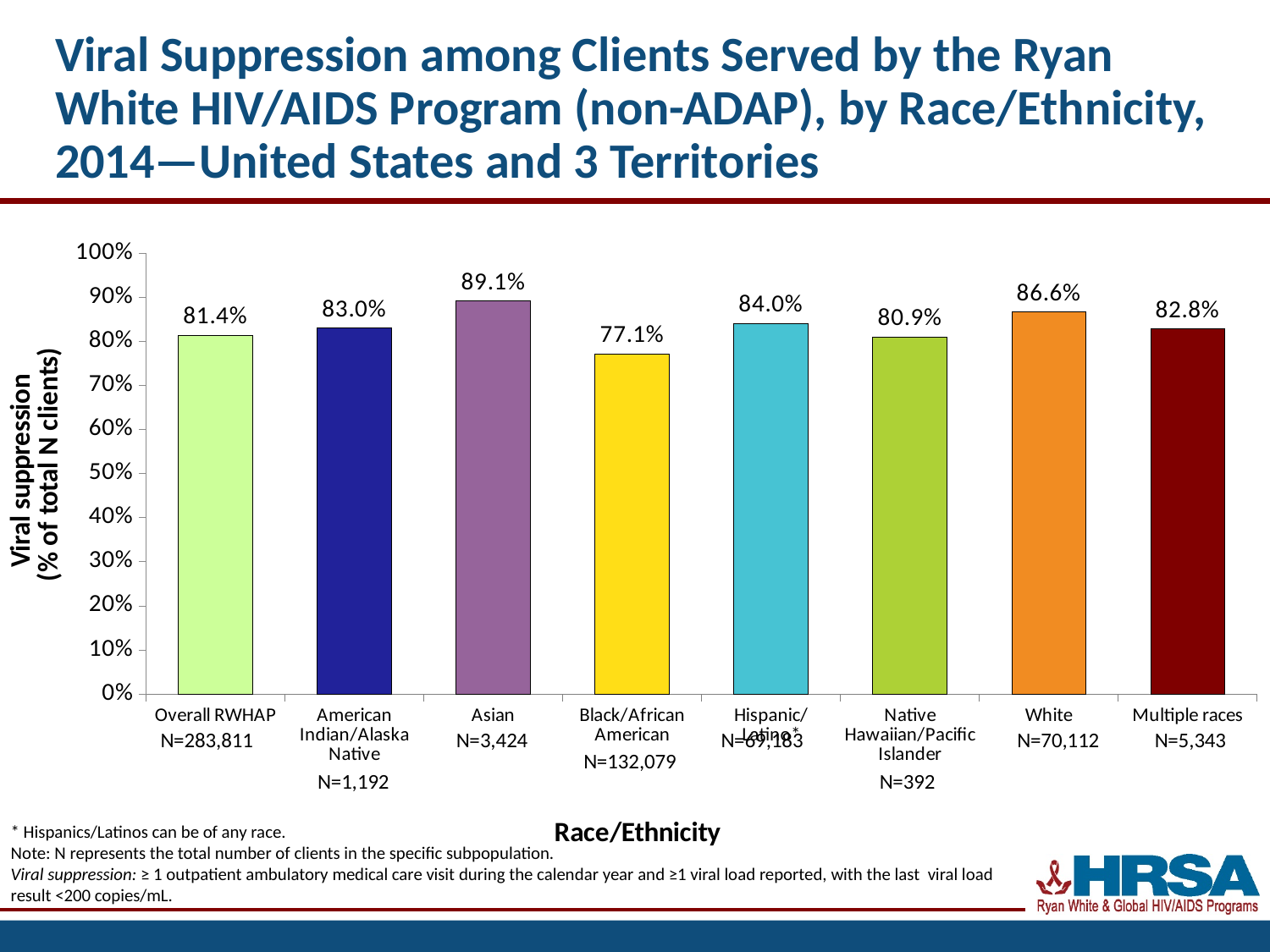
What is the viral suppression percentage for Black/African American clients? 77.1% Is the viral suppression value for Multiple races greater or less than 80%? greater How many race/ethnicity categories are shown on the chart? 8 What kind of chart is shown on the slide? Bar chart What is the viral suppression percentage for the Overall RWHAP category? 81.4% What is the label of the x axis? Race/Ethnicity Which race/ethnicity category has the lowest viral suppression percentage? Black/African American What is the difference in viral suppression between White clients and Black/African American clients? 9.5% Which race/ethnicity category has the highest viral suppression percentage? Asian Which has a higher viral suppression percentage, Hispanic/Latino or Native Hawaiian/Pacific Islander? Hispanic/Latino What is the N (number of clients) shown for the White category? N=70,112 What is the viral suppression percentage for Asian clients? 89.1%